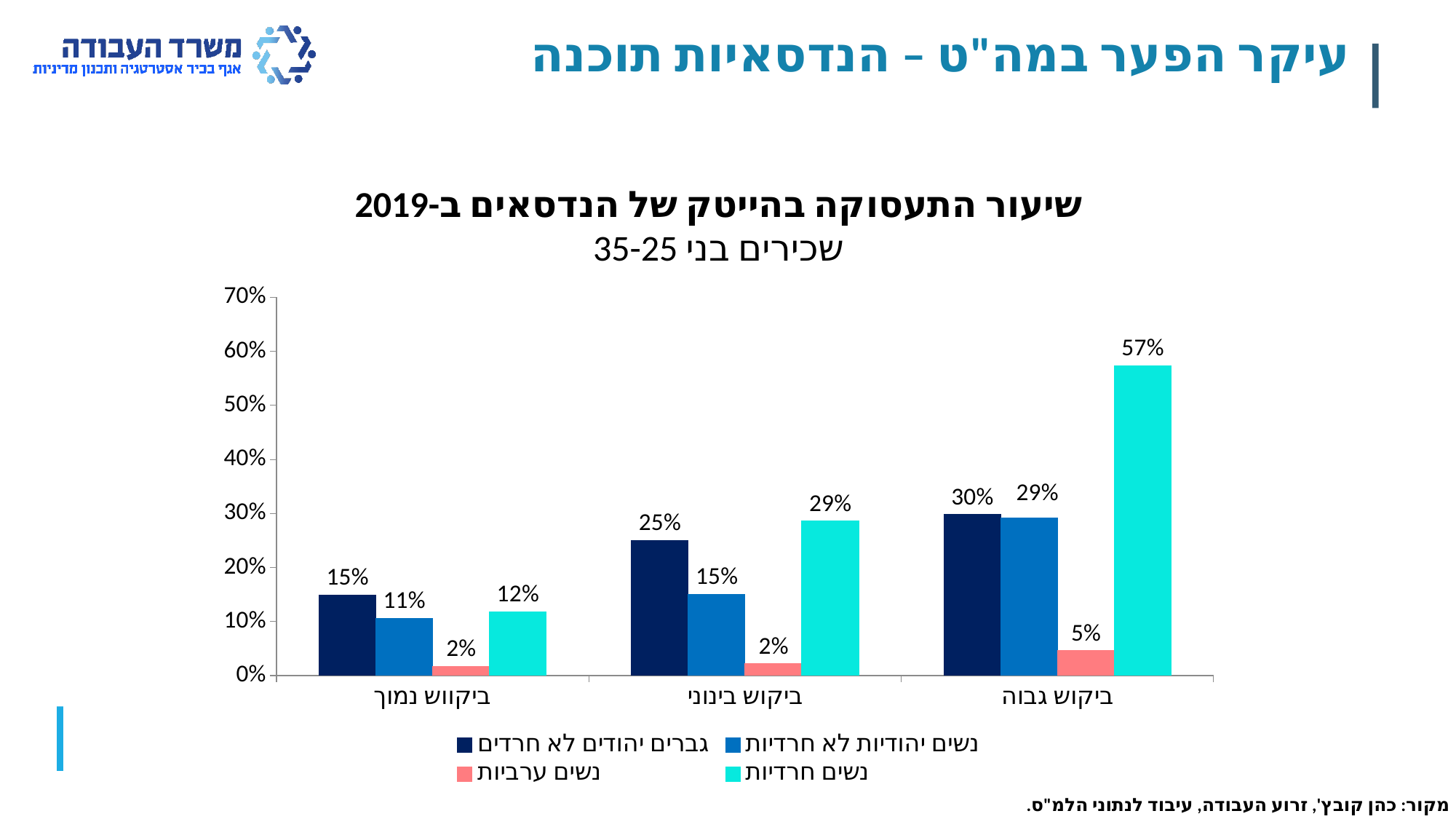
Which series has the lowest value in the ביקוש בינוני category? נשים ערביות In the ביקוש נמוך category, which is larger: גברים יהודים לא חרדים or נשים חרדיות? גברים יהודים לא חרדים What is the value for נשים יהודיות לא חרדיות in the ביקוש גבוה category? 29% What is the difference between נשים חרדיות and גברים יהודים לא חרדים in the ביקוש גבוה category? 27% What is the value for נשים חרדיות in the ביקוש גבוה category? 57% How many series does the legend list? 4 What kind of chart is shown on the slide? Bar chart How many categories are shown on the x axis? 3 Which series has the highest value in the ביקוש גבוה category? נשים חרדיות What is the value for נשים ערביות in the ביקוש נמוך category? 2% Do the values for נשים חרדיות rise or fall from ביקוש נמוך to ביקוש גבוה? Rise What is the value for גברים יהודים לא חרדים in the ביקוש בינוני category? 25%